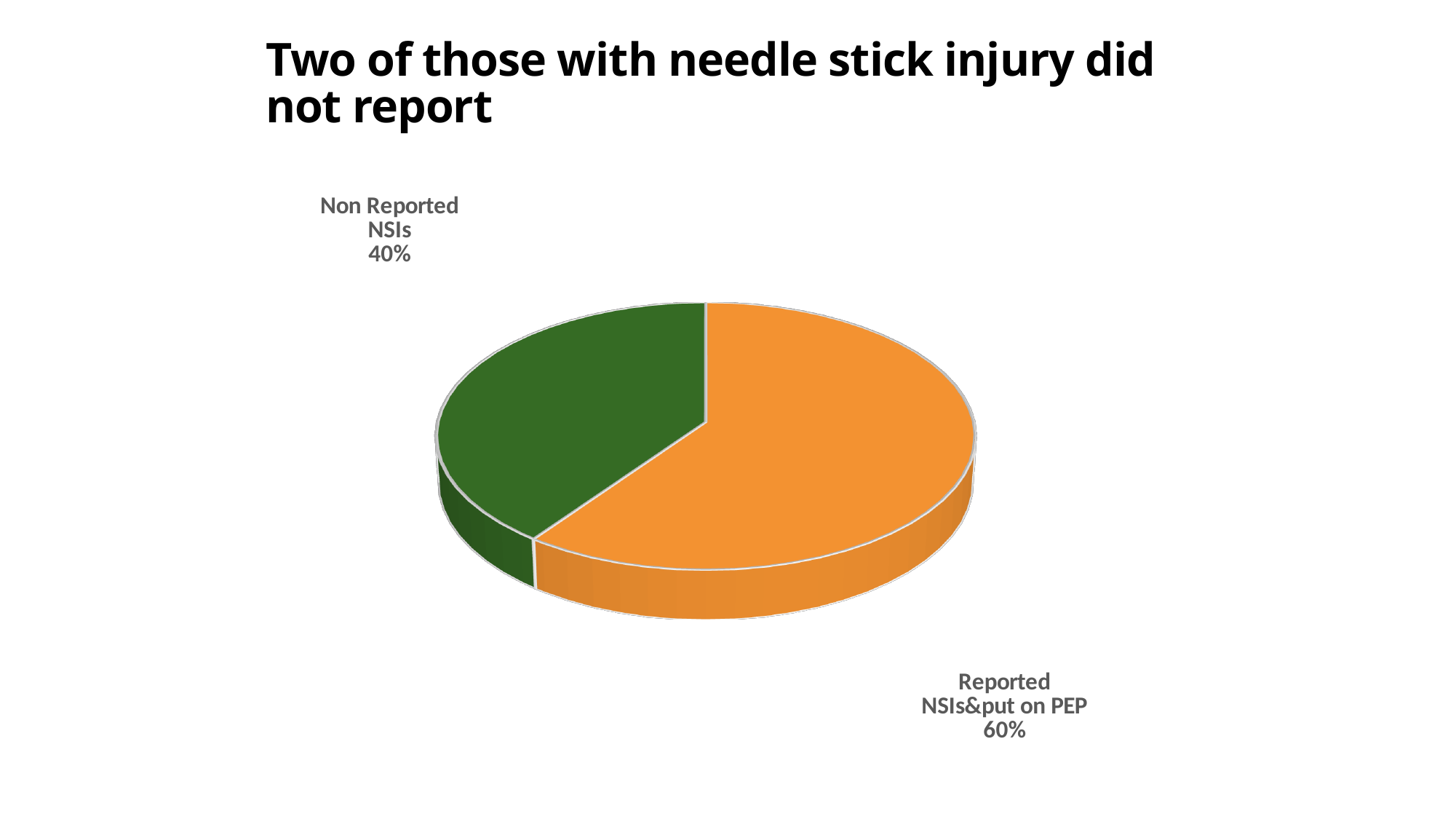
What kind of chart is shown on the slide? Pie chart What percentage of the pie is labelled Non Reported NSIs? 40% What colour is the Reported NSIs&put on PEP slice? Orange What share of the pie does the Non Reported NSIs slice represent? 40% Which slice of the pie is the largest? Reported NSIs&put on PEP Which is larger: the Non Reported NSIs slice or the Reported NSIs&put on PEP slice? Reported NSIs&put on PEP What is the difference in percentage points between the Reported NSIs&put on PEP slice and the Non Reported NSIs slice? 20 How many slices does the pie chart have? 2 Which slice of the pie is the smallest? Non Reported NSIs What colour is the Non Reported NSIs slice? Green What percentage of the pie is labelled Reported NSIs&put on PEP? 60%